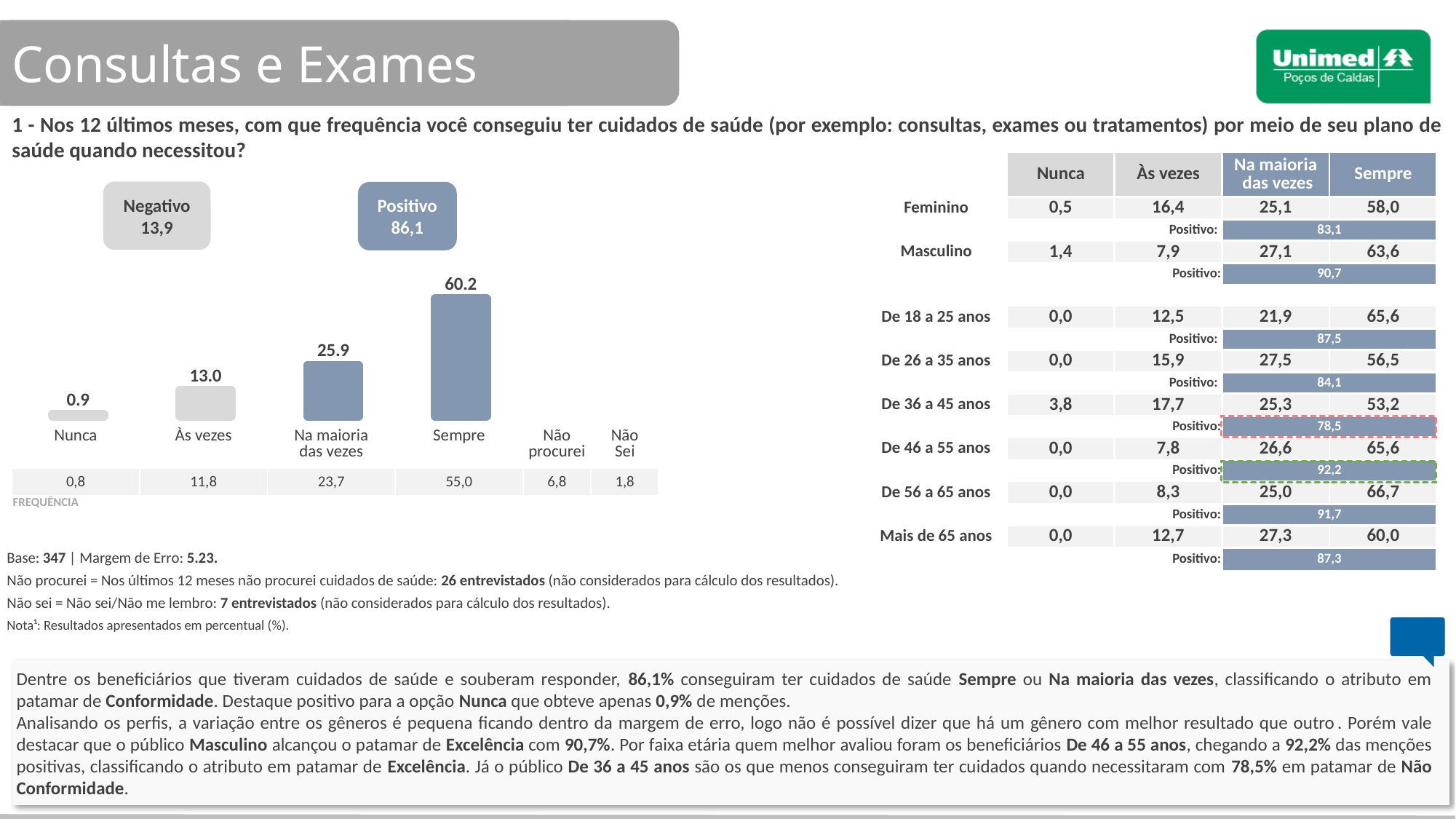
How many bars with values are plotted in the chart? 4 Do the bar values rise or fall from Nunca to Sempre along the x axis? Rise What is the difference between the values for Sempre and Na maioria das vezes? 34.3 What is the value of the bar for Na maioria das vezes? 25.9 What is the difference between the values for Às vezes and Nunca? 12.1 What kind of chart is shown on the slide? Bar chart What is the value of the bar for Às vezes? 13.0 What is the value of the bar for Nunca? 0.9 What is the value of the bar for Sempre? 60.2 Which category has the highest bar? Sempre Which is larger, the value for Às vezes or the value for Na maioria das vezes? Na maioria das vezes Which category has the lowest bar? Nunca